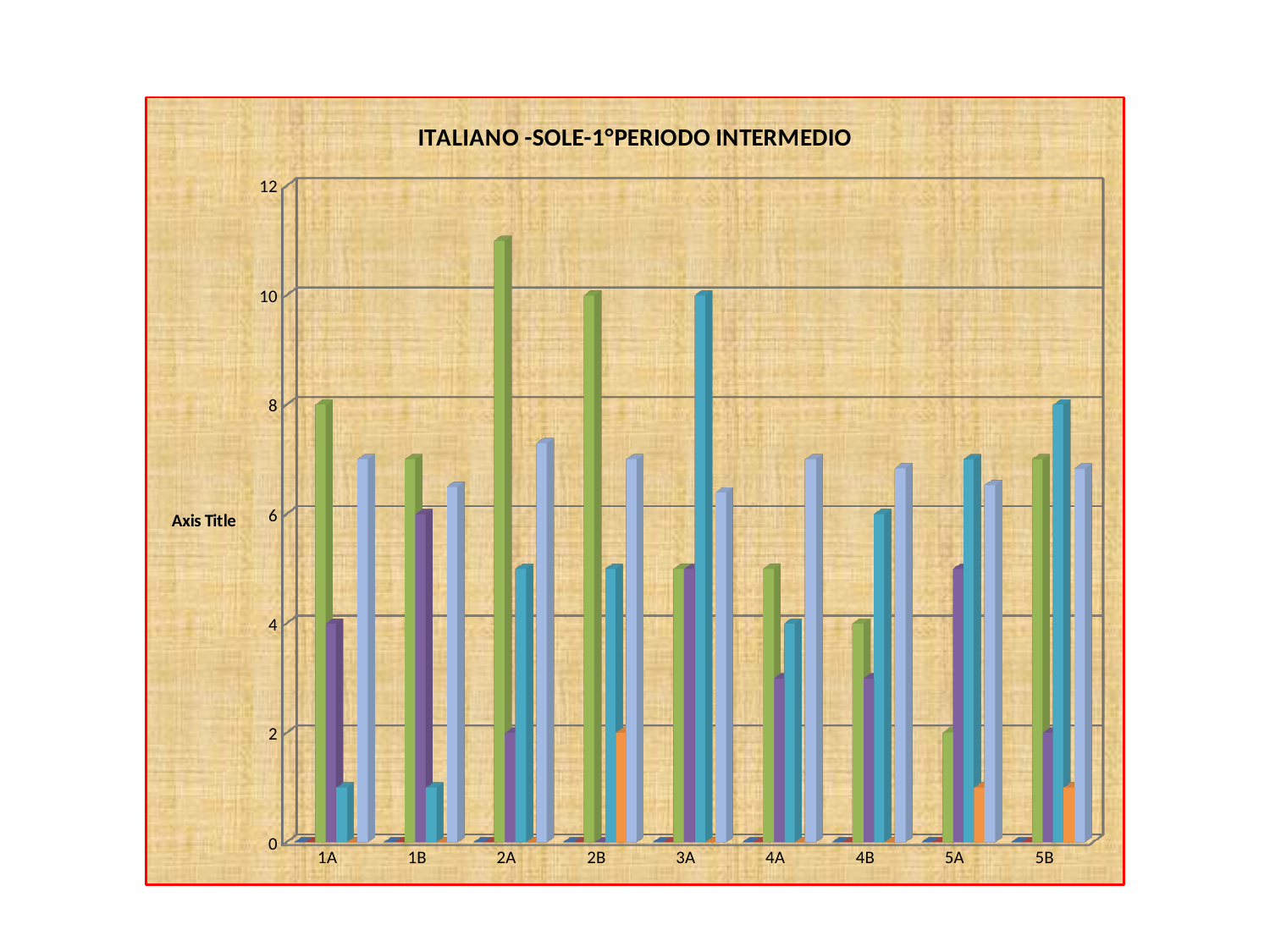
Is the green bar for 5A greater or less than 4? less Which category has the tallest green bar? 2A Is the green bar for 4B greater or less than 6? less How many categories are shown on the x axis of the chart? 9 Is the green bar for 2A greater or less than 10? greater Which is larger, the green bar for 2A or the green bar for 5A? 2A What kind of chart is shown on the slide? bar chart What is the title of the chart? ITALIANO -SOLE-1°PERIODO INTERMEDIO What label is shown on the vertical axis of the chart? Axis Title